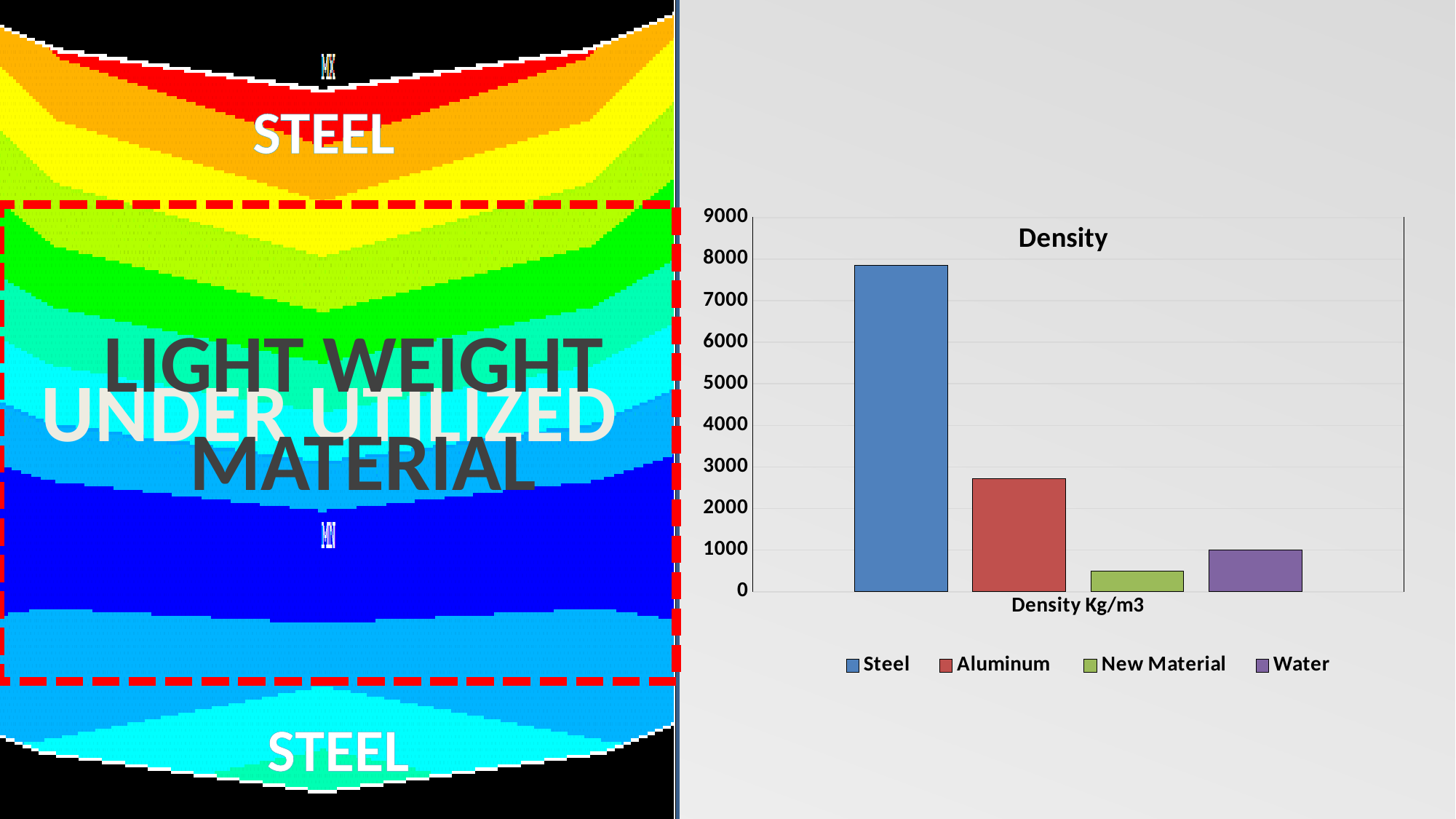
What is the highest value shown on the chart's vertical axis? 9000 Which material has the highest density in the chart? Steel Which has a higher density, Water or New Material? Water Is the value for Aluminum greater or less than 3000? less Is the value for Steel greater or less than 7000? greater Which has a higher density, Aluminum or Water? Aluminum Which material has the lowest density in the chart? New Material What kind of chart is shown on the slide? bar chart What is the label shown on the x axis of the chart? Density Kg/m3 Is the value for New Material greater or less than 1000? less How many series does the chart legend list? 4 What is the title of the chart? Density